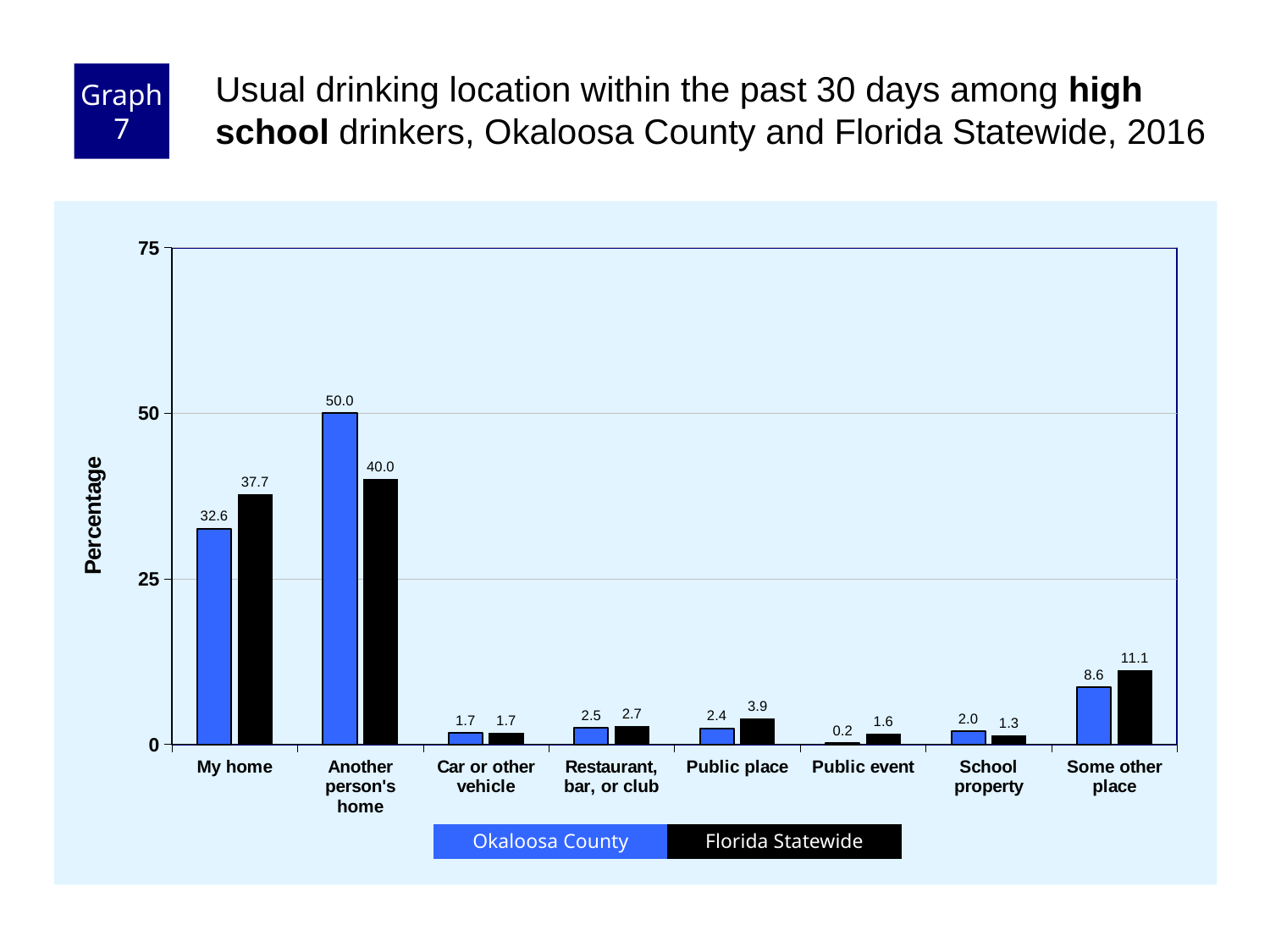
How many categories are shown on the x axis? 8 For "My home", which is larger: the Okaloosa County value or the Florida Statewide value? Florida Statewide What is the Okaloosa County value for "Public event"? 0.2 Which category has the lowest Okaloosa County value? Public event What is the difference between the Florida Statewide and Okaloosa County values for "Some other place"? 2.5 What is the Okaloosa County value for "Another person's home"? 50.0 What is the Florida Statewide value for "My home"? 37.7 How many series does the legend list? 2 What kind of chart is shown on the slide? Bar chart Which category has the highest Okaloosa County value? Another person's home Is the Okaloosa County value for "My home" greater or less than 25? greater What is the difference between the Okaloosa County and Florida Statewide values for "Another person's home"? 10.0